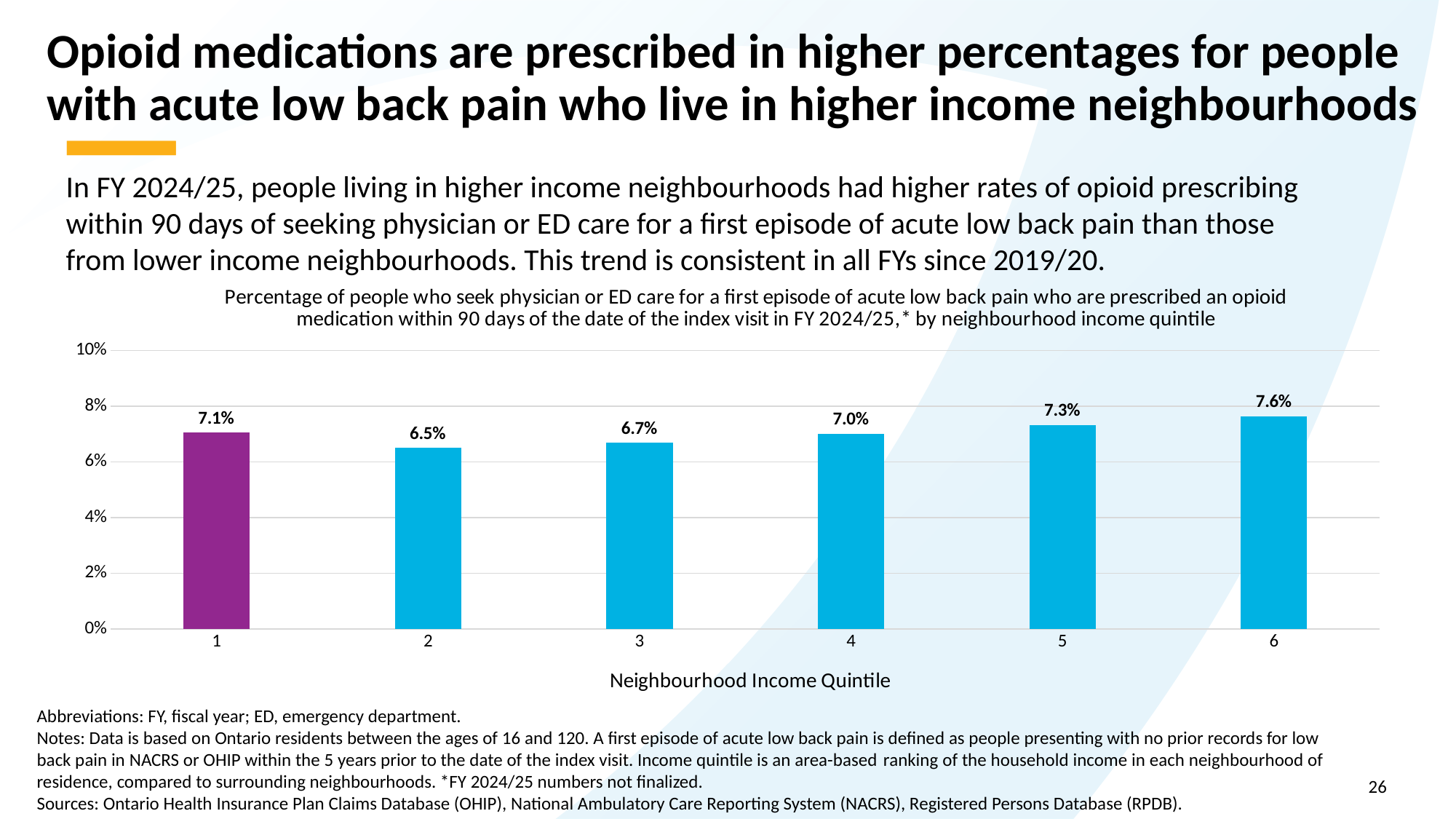
What is the value for neighbourhood income quintile 1? 7.1% What is the difference between the values for quintile 1 and quintile 3? 0.4% Which neighbourhood income quintile has the lowest percentage? 2 How many neighbourhood income quintile categories are shown on the chart? 6 What kind of chart is shown on the slide? Bar chart Which bar is coloured differently (purple) from the others? Quintile 1 Which neighbourhood income quintile has the highest percentage? 6 Is the value for quintile 6 greater or less than 6%? greater What is the value for neighbourhood income quintile 2? 6.5% What is the difference between the values for quintile 6 and quintile 2? 1.1% What is the value for neighbourhood income quintile 5? 7.3% Which is larger, the value for quintile 4 or the value for quintile 3? Quintile 4